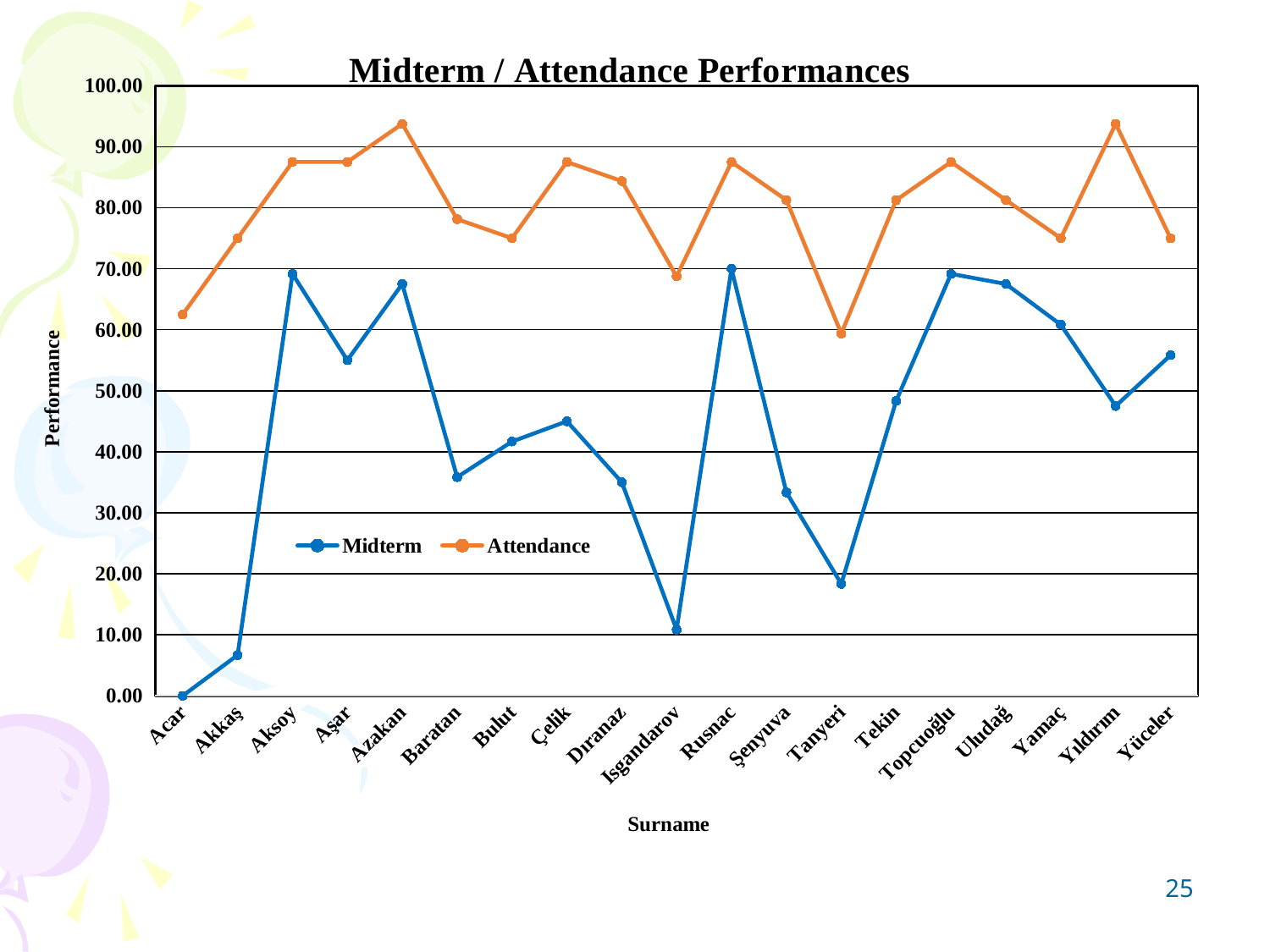
Which is larger, the Midterm value for Yüceler or for Yıldırım? Yüceler Is the Midterm value for Tanyeri greater or less than 20.00? less Which surname has the lowest Midterm value? Acar Which is larger, the Midterm value for Aksoy or for Aşar? Aksoy What kind of chart is shown on the slide? Line chart How many series does the legend list? 2 Which surname has the lowest Attendance value? Tanyeri Is the Attendance value for Aksoy greater or less than 80.00? greater Is the Midterm value for Azakan greater or less than 60.00? greater What is the title of the chart? Midterm / Attendance Performances How many surnames are plotted along the x axis? 19